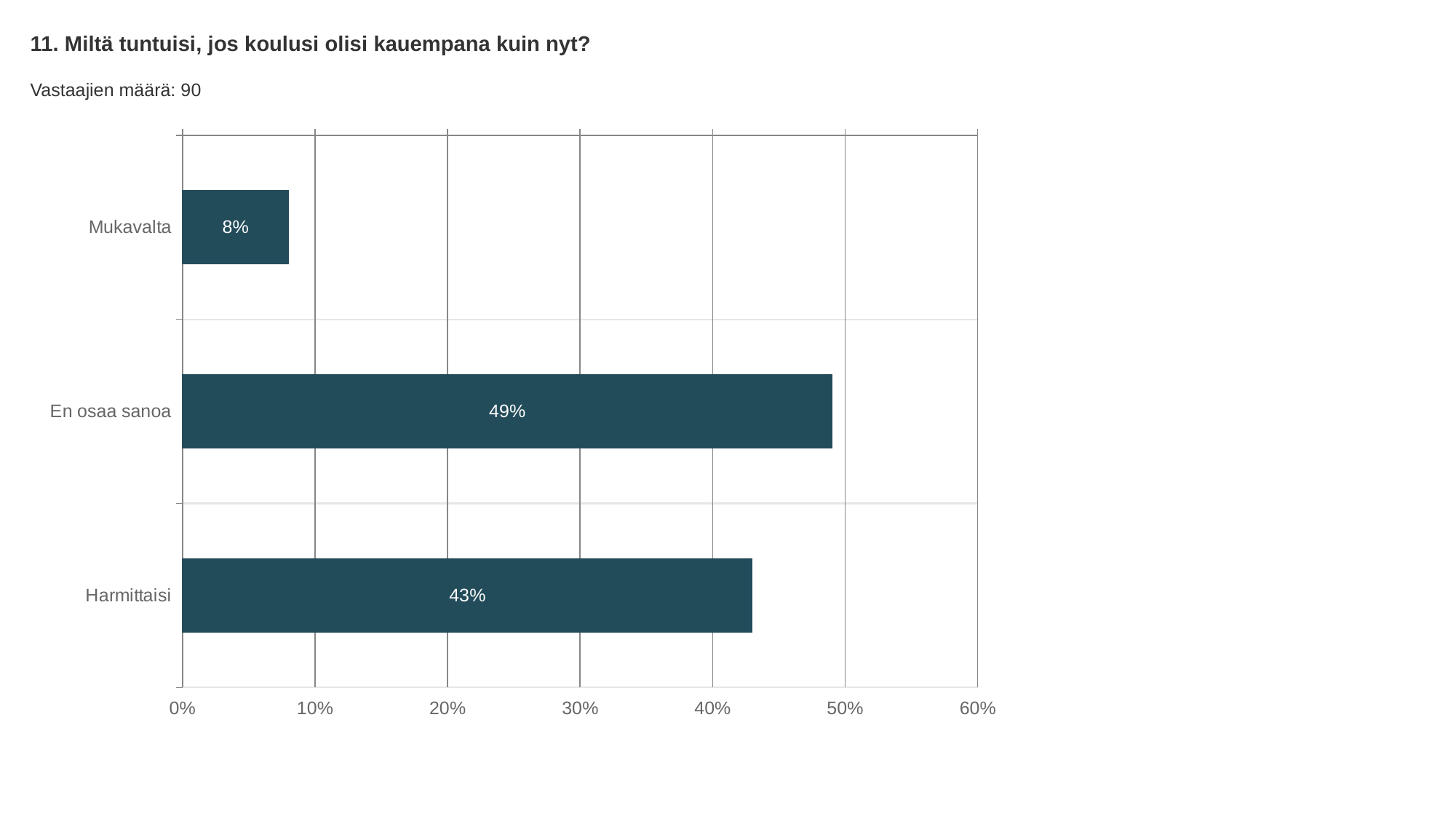
What is the difference between the values for Harmittaisi and Mukavalta? 35% Is the value for Harmittaisi greater or less than 40%? greater Which category has the lowest value? Mukavalta How many respondents (Vastaajien määrä) does the slide report? 90 What is the value for Harmittaisi? 43% Which is larger, the value for Harmittaisi or the value for Mukavalta? Harmittaisi How many categories are shown in the chart? 3 Which category has the highest value? En osaa sanoa What is the difference between the values for En osaa sanoa and Harmittaisi? 6% What is the value for En osaa sanoa? 49% What kind of chart is shown on the slide? bar chart What is the value for Mukavalta? 8%